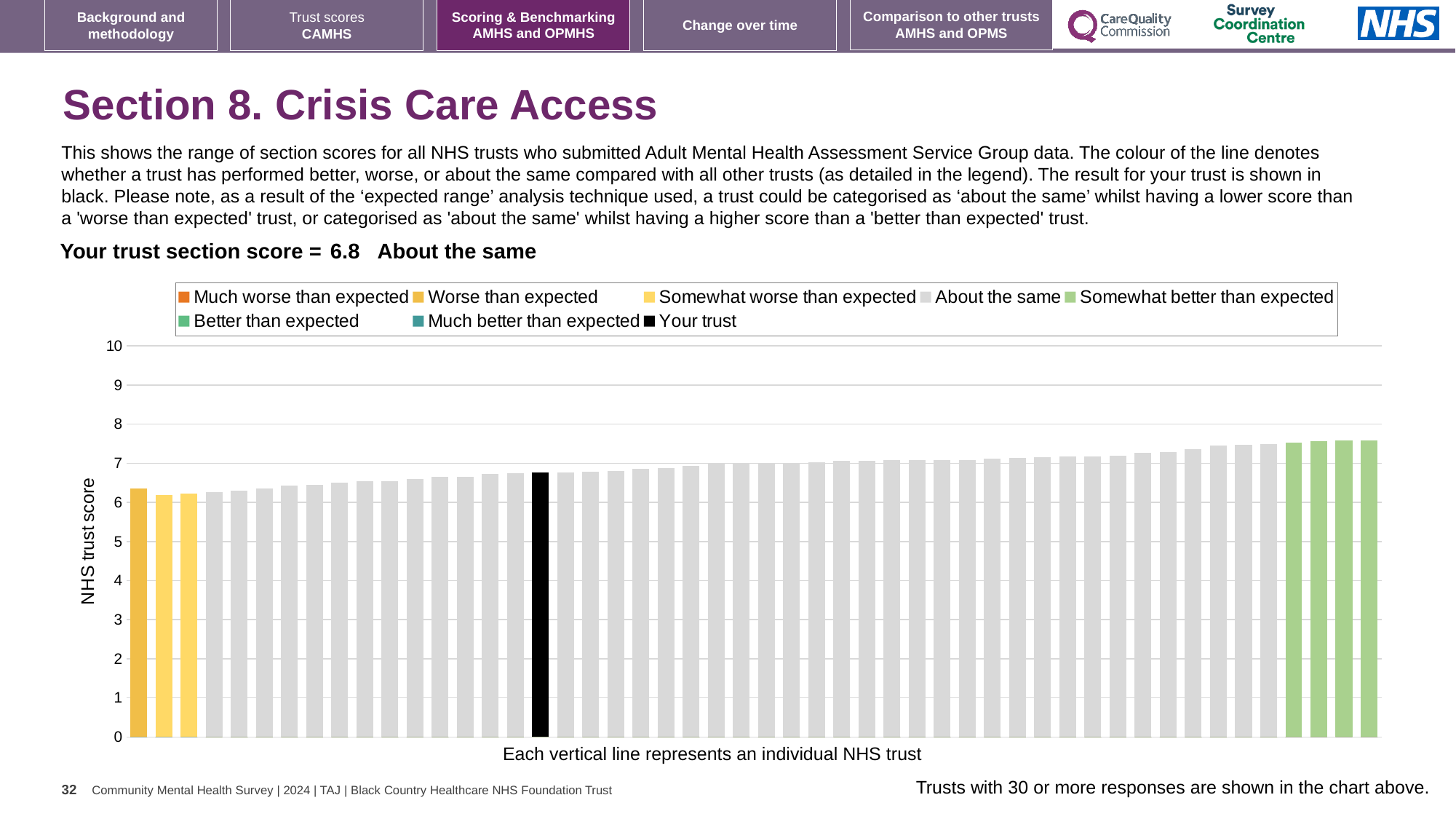
Which category is your trust's section score placed in? About the same Is the value for your trust (the black bar) greater or less than 7? less Do the bar values rise or fall from left to right along the x axis? rise What is the label on the vertical axis of the chart? NHS trust score How many entries does the chart legend list? 8 What is the section score for your trust? 6.8 Is the value for your trust (the black bar) greater or less than 6? greater Is the value of the tallest bar in the chart greater or less than 8? less What kind of chart is shown on the slide? bar chart What colour is the bar representing your trust? black How many green bars (somewhat better than expected) are shown at the right of the chart? 4